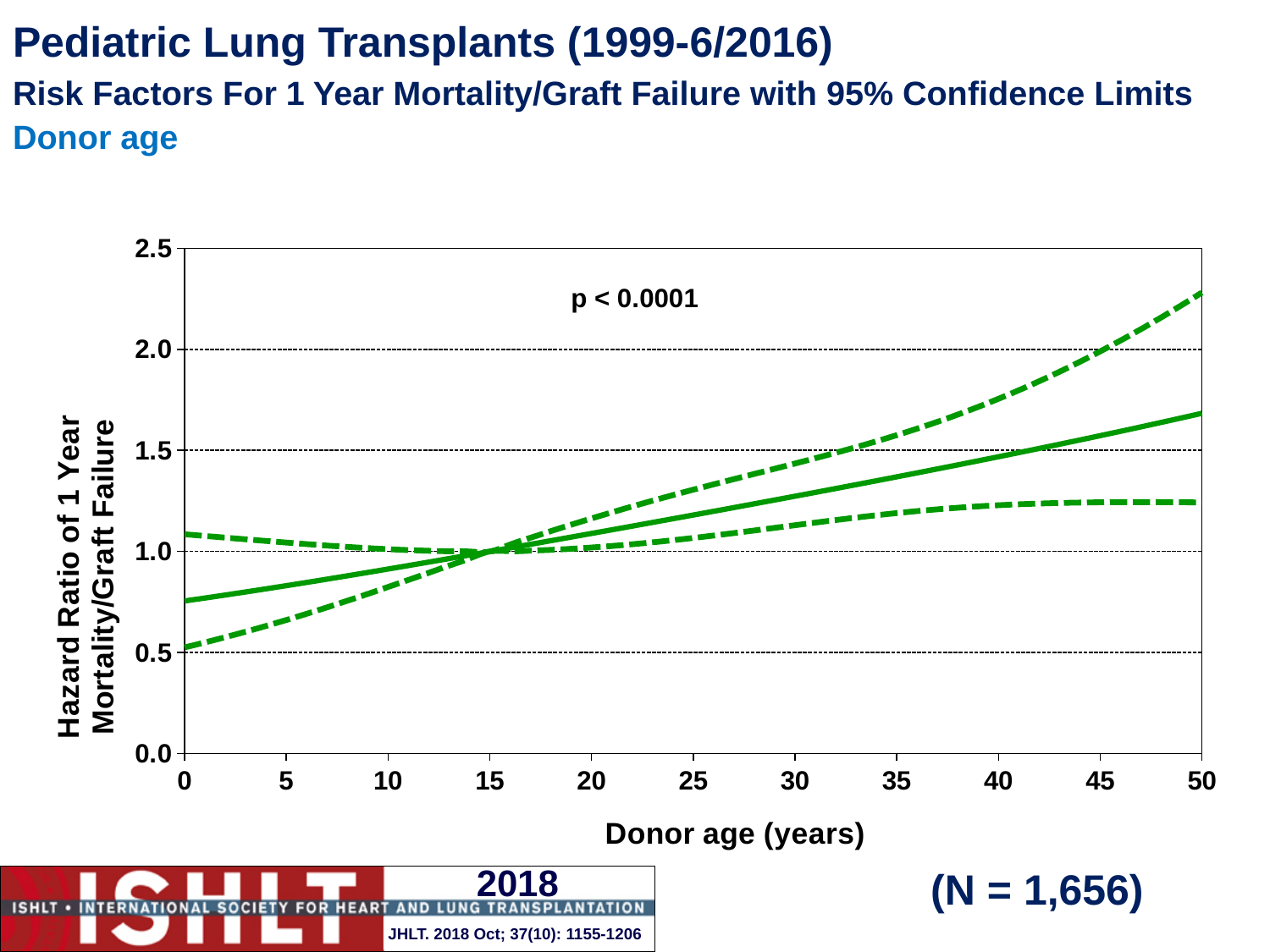
Is the hazard ratio (solid line) at donor age 0 greater or less than 1.0? less Is the upper confidence limit (upper dashed line) at donor age 0 greater or less than 1.0? greater Is the lower confidence limit (lower dashed line) at donor age 50 greater or less than 1.5? less What p-value is printed on the chart? p < 0.0001 What sample size (N) is shown on the slide? N = 1,656 How many lines are plotted on the chart? 3 What kind of chart is shown on the slide? line chart Does the solid hazard ratio line rise or fall as donor age increases from 0 to 50 years? rise